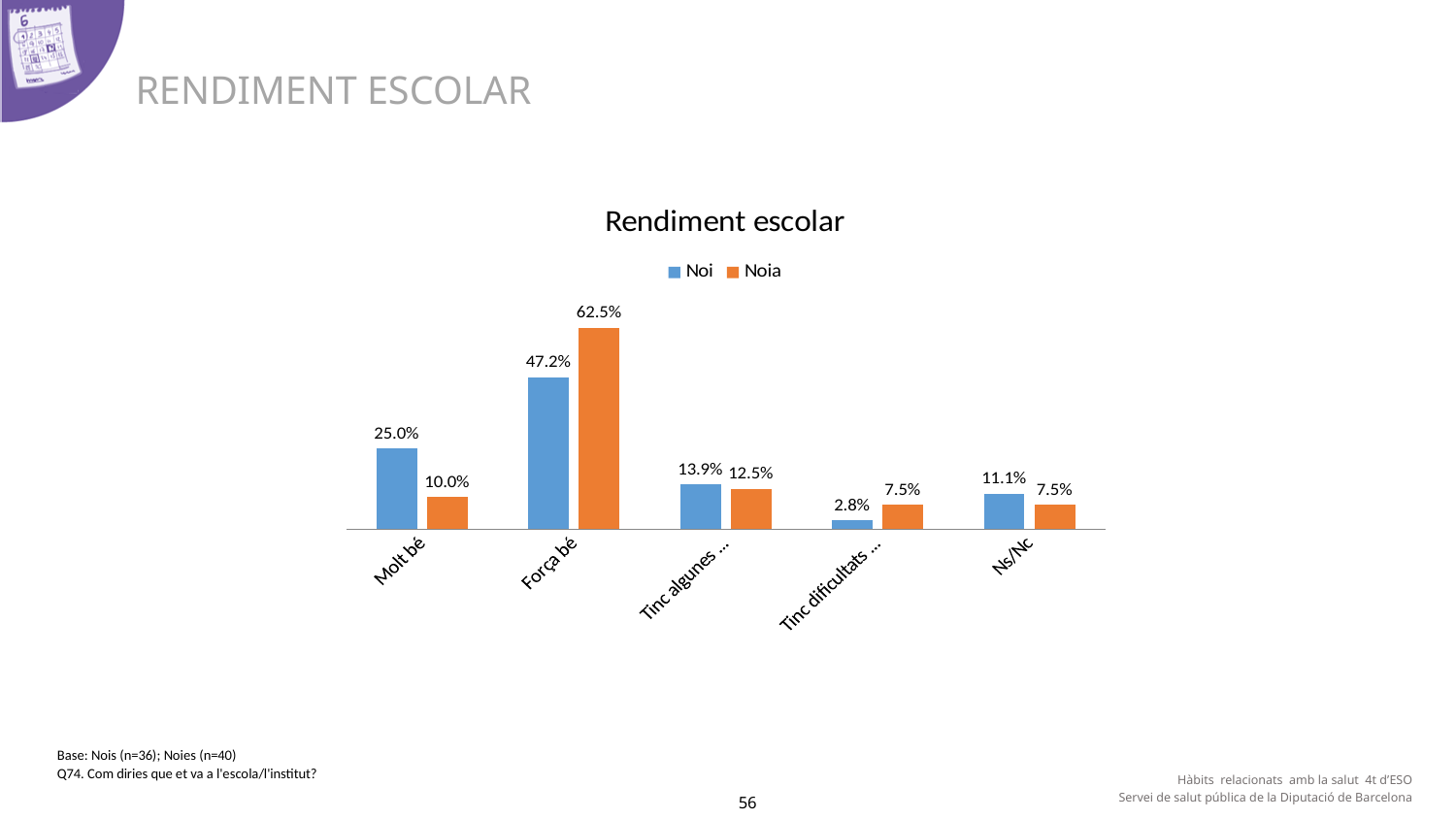
What is the difference between the Noia and Noi values in the Força bé category? 15.3% What kind of chart is shown on the slide? Bar chart What is the difference between the Noi and Noia values in the Molt bé category? 15.0% How many series does the legend list? 2 What is the value for Noi in the Molt bé category? 25.0% Which category has the highest value for the Noia series? Força bé What is the value for Noi in the Força bé category? 47.2% In the Ns/Nc category, which series has the larger value, Noi or Noia? Noi What is the value for Noia in the Ns/Nc category? 7.5% How many categories are shown on the x axis? 5 What is the value for Noia in the Força bé category? 62.5% Which category has the lowest value for the Noi series? Tinc dificultats ...